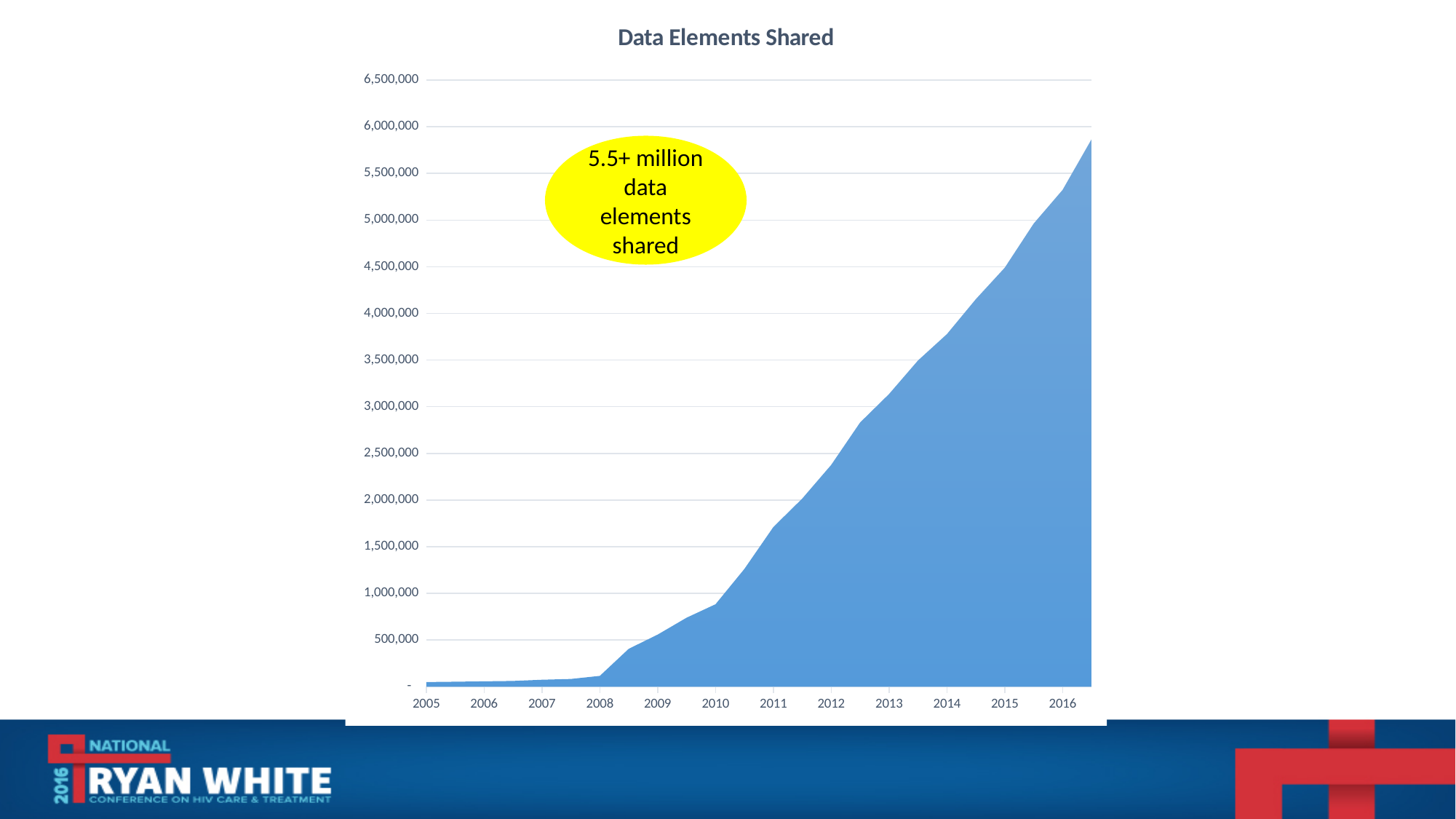
Which year has the lowest value in the chart? 2005 What kind of chart is shown on the slide? Area chart Do the values in the chart rise or fall from 2005 to 2016? Rise Is the value for 2016 greater or less than 5,000,000? greater Is the value for 2012 greater or less than 2,000,000? greater Which year has the larger value, 2011 or 2015? 2015 Which year has the highest value in the chart? 2016 Is the value for 2014 greater or less than 3,500,000? greater How many years are labelled on the x axis of the chart? 12 What is the title of the chart? Data Elements Shared